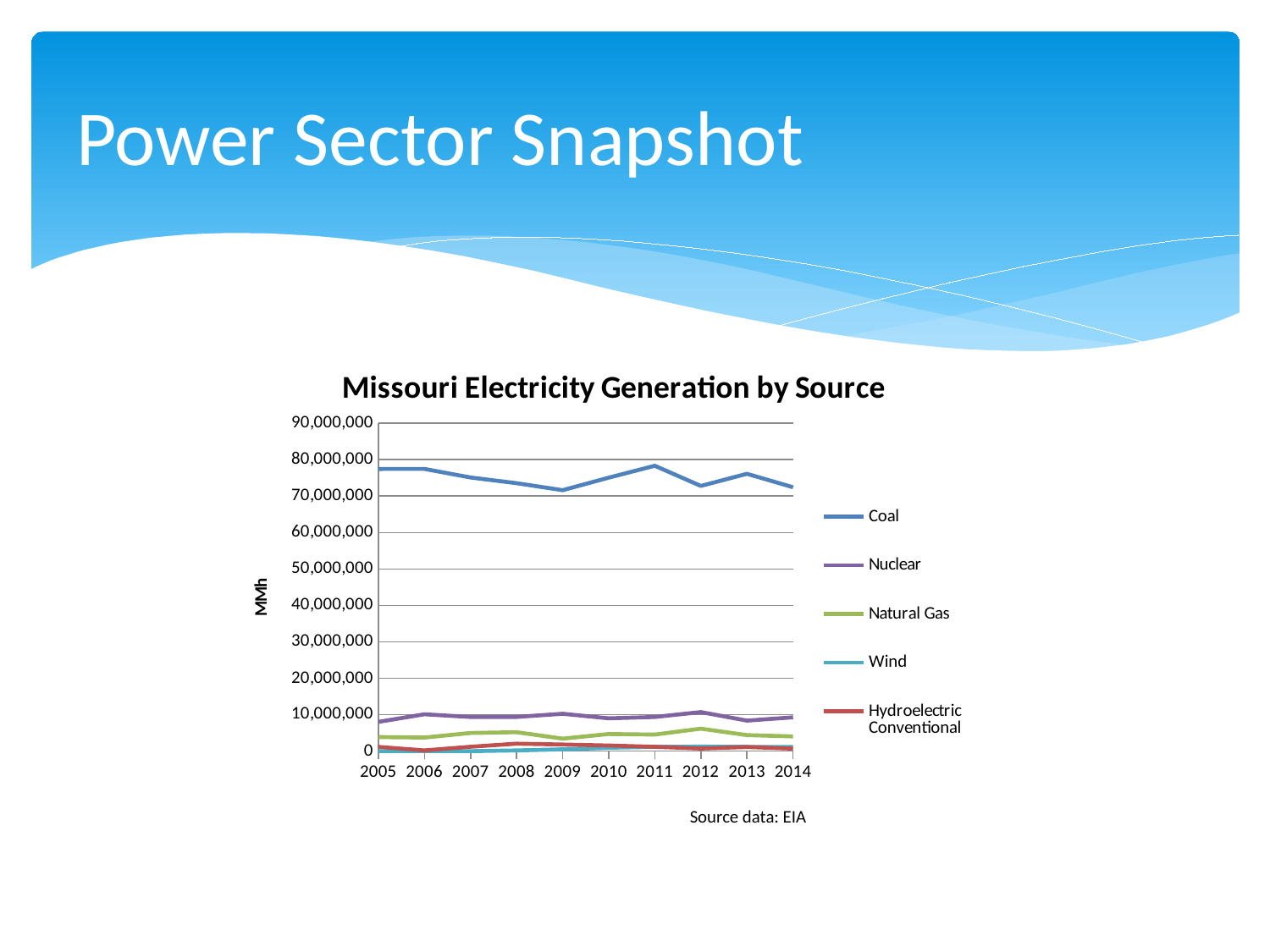
How many years are plotted along the x axis? 10 What kind of chart is shown on the slide? line chart Which source has the highest electricity generation across all years? Coal Is the value for Natural Gas in 2012 greater or less than 10,000,000? less Is the value for Coal in 2005 greater or less than 70,000,000? greater Is the value for Nuclear in 2012 greater or less than 20,000,000? less Does the Coal line rise or fall between 2009 and 2011? rise What is the title of the chart? Missouri Electricity Generation by Source Which is larger in 2009, Nuclear or Natural Gas? Nuclear Which is larger in 2010, Coal or Nuclear? Coal How many series does the legend list? 5